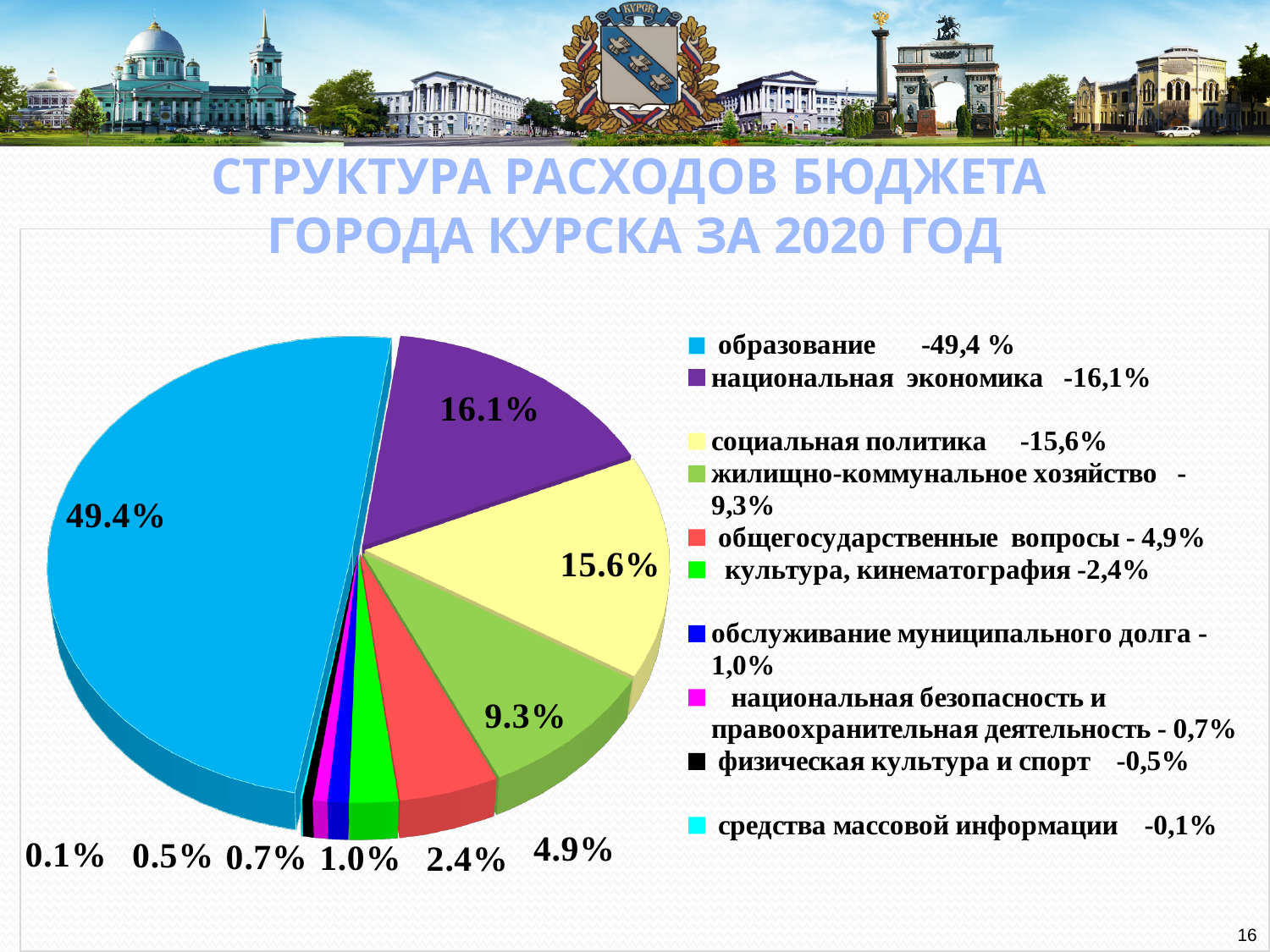
What is the value shown for культура, кинематография? 2.4% How many categories does the legend of the pie chart list? 10 What colour is the slice for образование in the pie chart? light blue Which category has the smallest slice of the pie? средства массовой информации What is the value shown for национальная экономика? 16.1% What is the value shown for жилищно-коммунальное хозяйство? 9.3% What is the title of the chart on the slide? СТРУКТУРА РАСХОДОВ БЮДЖЕТА ГОРОДА КУРСКА ЗА 2020 ГОД What share of the pie does образование (education) take? 49.4% What kind of chart is shown on the slide? pie chart Which category has the largest slice of the pie? образование What is the difference between the shares of национальная экономика and социальная политика? 0.5% Which is larger: социальная политика or общегосударственные вопросы? социальная политика